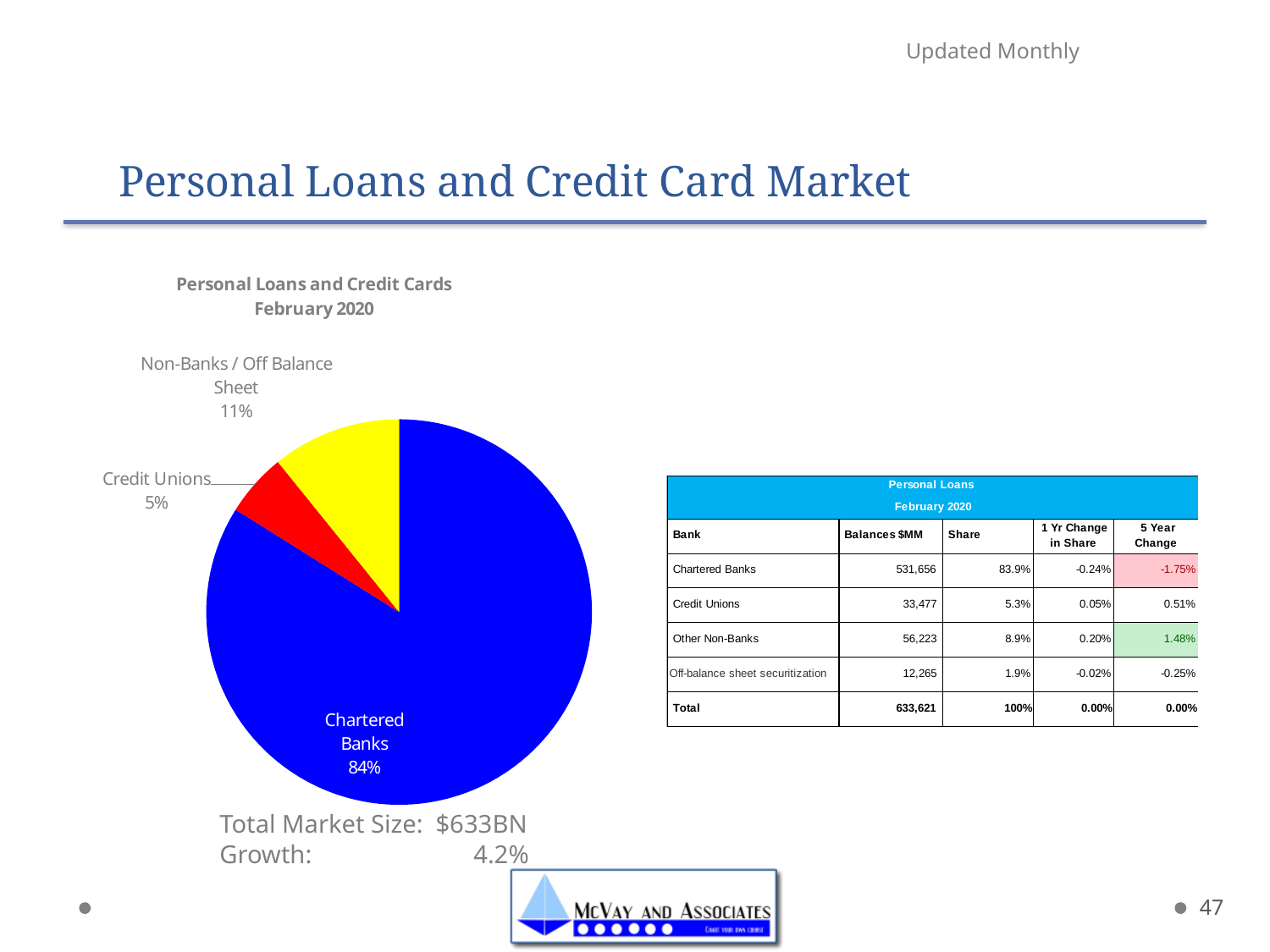
What is the difference in percentage points between the Chartered Banks slice and the Non-Banks / Off Balance Sheet slice? 73 What share of the pie chart does Credit Unions hold? 5% Which is larger in the pie chart, Credit Unions or Non-Banks / Off Balance Sheet? Non-Banks / Off Balance Sheet What is the title of the pie chart? Personal Loans and Credit Cards February 2020 What colour is the Chartered Banks slice in the pie chart? blue Which slice of the pie chart is the largest? Chartered Banks What is the difference in percentage points between the Non-Banks / Off Balance Sheet slice and the Credit Unions slice? 6 What kind of chart is shown on the slide? pie chart What share of the pie chart does Chartered Banks hold? 84% Which slice of the pie chart is the smallest? Credit Unions How many slices does the pie chart have? 3 What share of the pie chart does Non-Banks / Off Balance Sheet hold? 11%